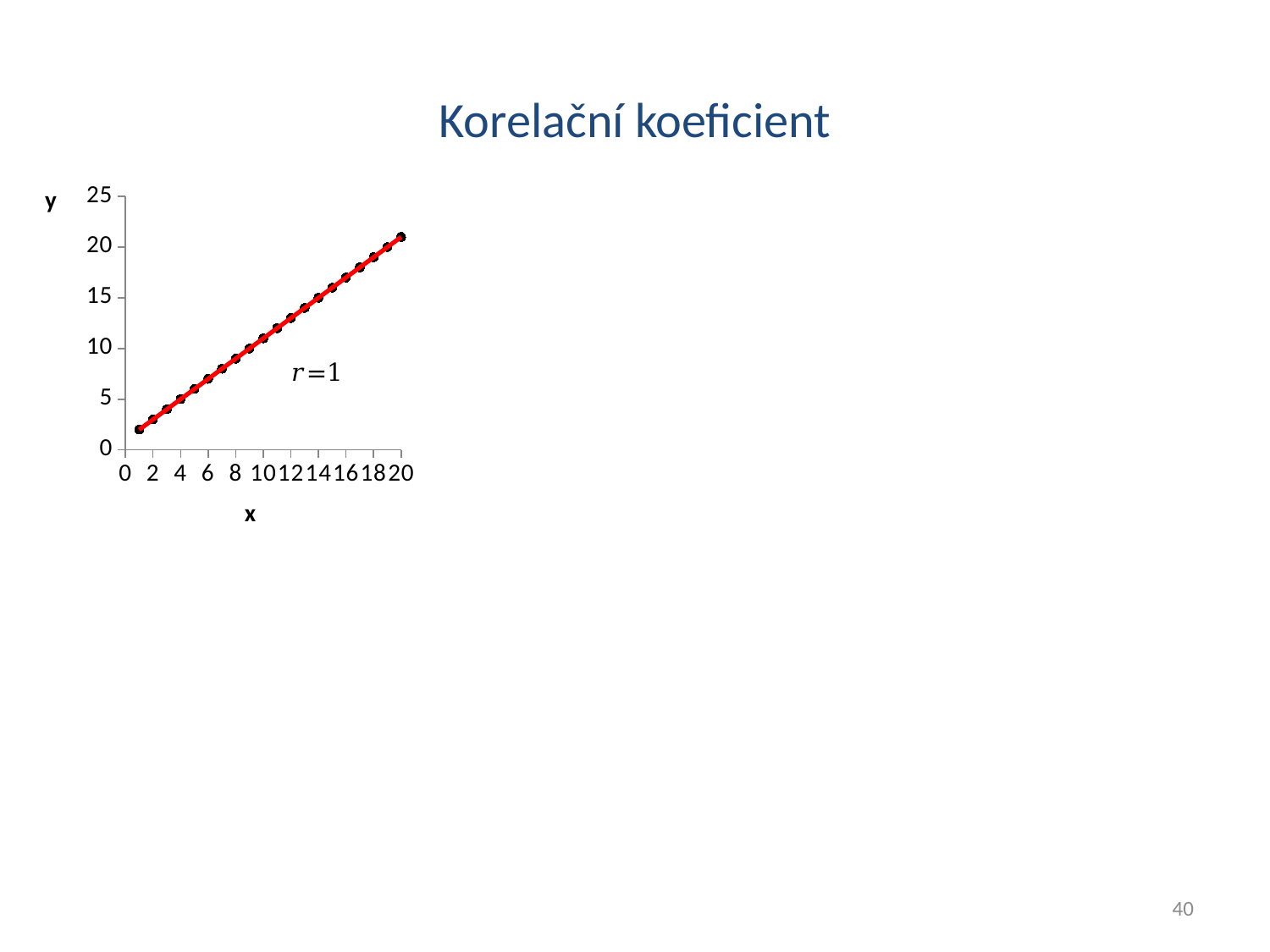
Is the y value of the point at x = 6 greater or less than 10? less Do the plotted y values rise or fall as x increases? rise What kind of chart is shown on the slide? scatter chart At which x value is the plotted y value highest? 20 What is the title of the slide containing the chart? Korelační koeficient Is the y value of the point at x = 16 greater or less than 10? greater Is the y value of the point at x = 10 greater or less than 15? less What value of the correlation coefficient r is annotated on the chart? r = 1 Which point has the higher y value: the one at x = 4 or the one at x = 18? x = 18 What is the maximum value shown on the y axis? 25